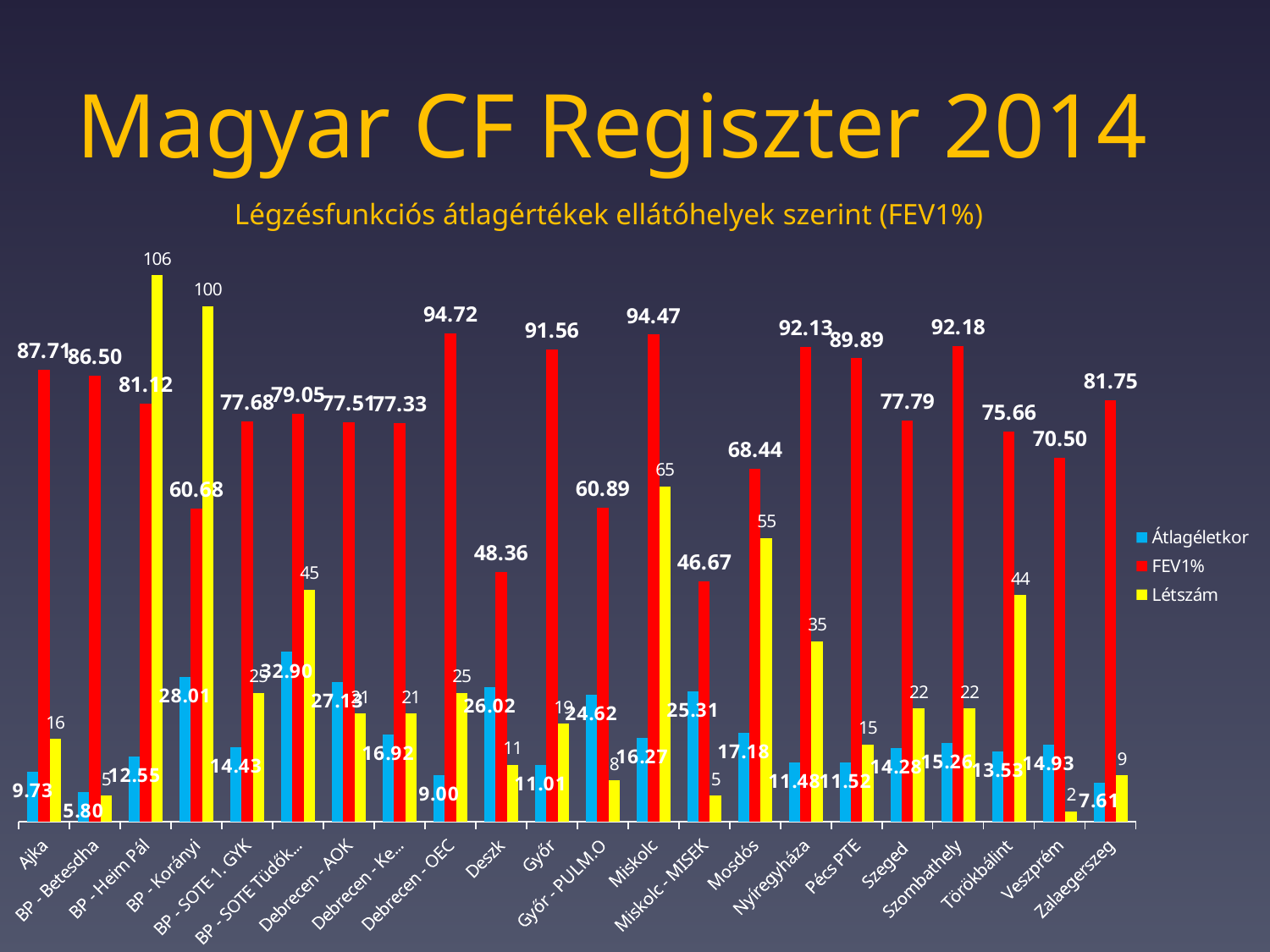
Which category has the highest Létszám value? BP - Heim Pál What type of chart is shown on the slide? bar chart What is the FEV1% value for Debrecen - OEC? 94.72 Which category has the lowest Átlagéletkor value? BP - Betesdha What is the Átlagéletkor value for BP - SOTE Tüdők...? 32.90 What is the Létszám value for BP - Heim Pál? 106 What is the difference between the Létszám values for BP - Heim Pál and BP - Korányi? 6 Which category has the lowest FEV1% value? Miskolc - MISEK What is the title of the chart? Légzésfunkciós átlagértékek ellátóhelyek szerint (FEV1%) How many categories are shown on the x axis? 22 Which has a larger FEV1% value, Miskolc or Mosdós? Miskolc How many series does the legend list? 3